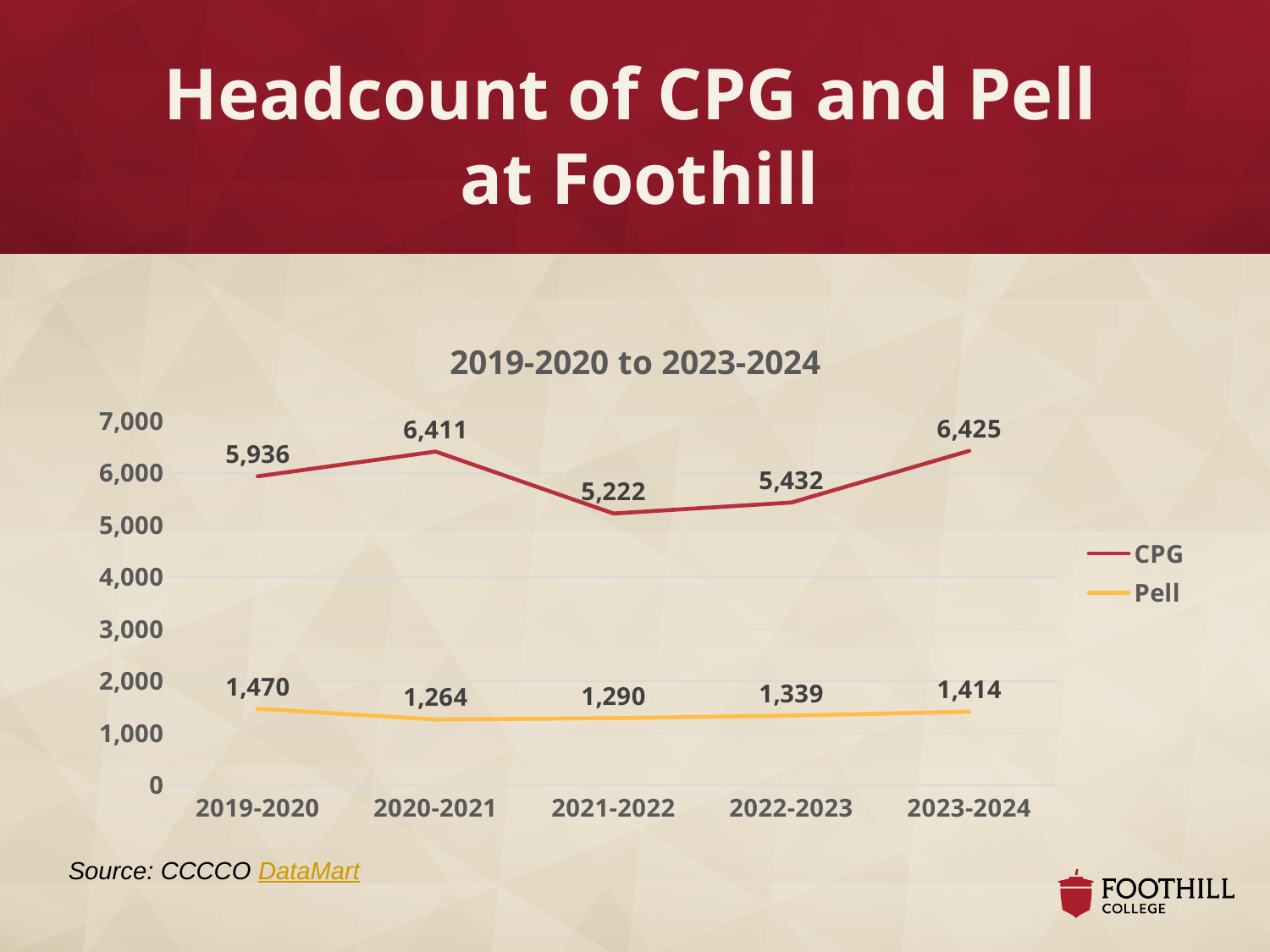
In which year is the CPG headcount highest? 2023-2024 Which is larger, the Pell headcount in 2019-2020 or in 2023-2024? 2019-2020 Does the Pell headcount rise or fall from 2020-2021 to 2023-2024? rise What is the difference between the CPG headcount in 2023-2024 and in 2021-2022? 1,203 What is the Pell headcount for 2022-2023? 1,339 What colour is the line for Pell? yellow In which year is the Pell headcount lowest? 2020-2021 How many series does the legend list? 2 How many academic years are shown on the x axis? 5 Is the CPG headcount for 2021-2022 greater or less than 5,000? greater What is the CPG headcount for 2020-2021? 6,411 What kind of chart is shown on the slide? line chart